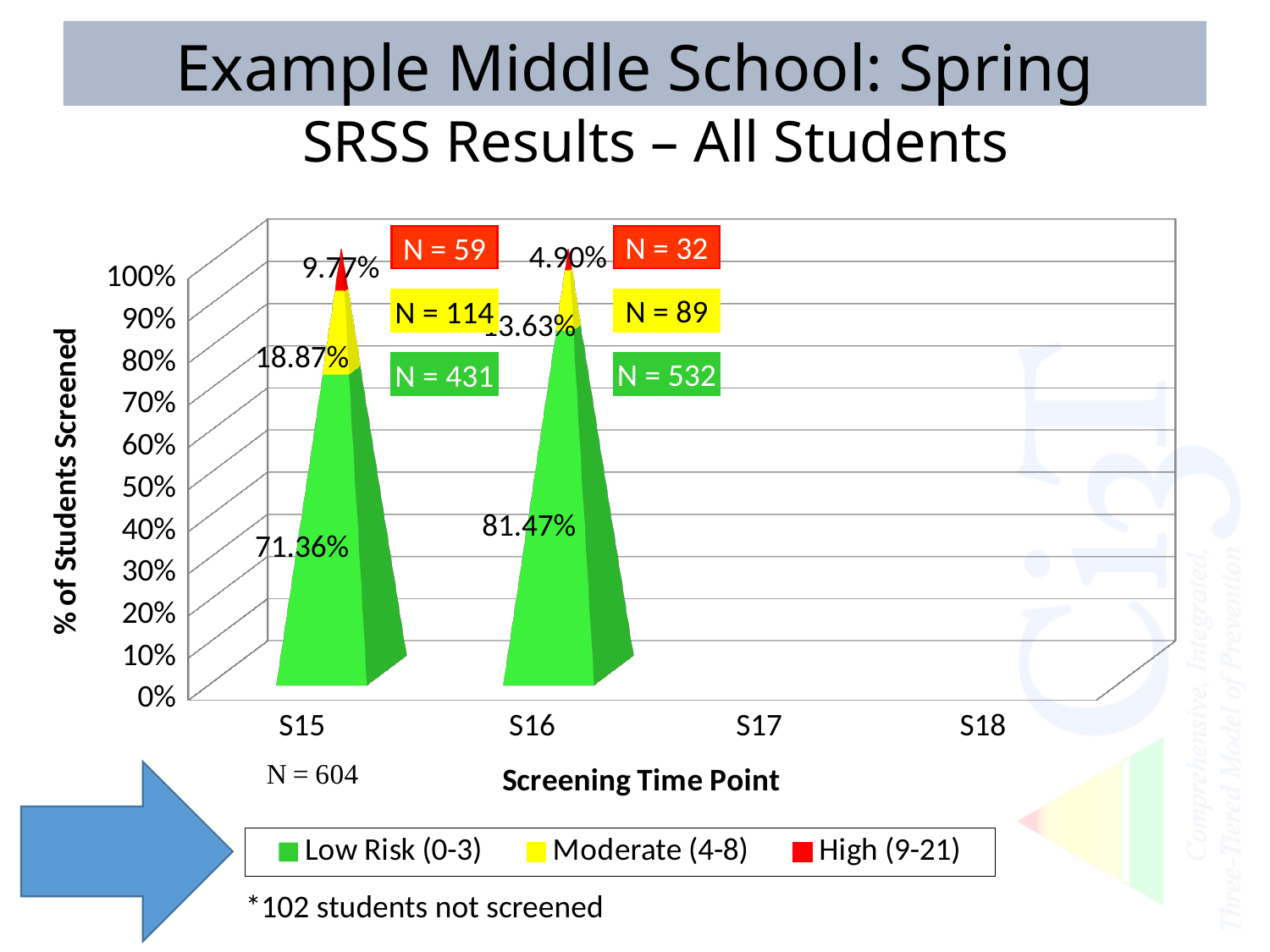
What is the difference in percentage points between the High (9-21) share at S15 and at S16? 4.87 What percentage of students screened at S15 were Moderate (4-8)? 18.87% What is the label of the y axis? % of Students Screened How many students were in the Low Risk (0-3) group at S16, according to the N label? N = 532 How many screening time points are labelled on the x axis? 4 What is the difference in percentage points between the Low Risk (0-3) share at S16 and at S15? 10.11 Which screening time point has the higher Low Risk (0-3) percentage, S15 or S16? S16 How many students were in the High (9-21) group at S15, according to the N label? N = 59 What percentage of students screened at S16 were High (9-21)? 4.90% What percentage of students screened at S15 were Low Risk (0-3)? 71.36% What percentage of students screened at S16 were Moderate (4-8)? 13.63% How many series does the legend list? 3